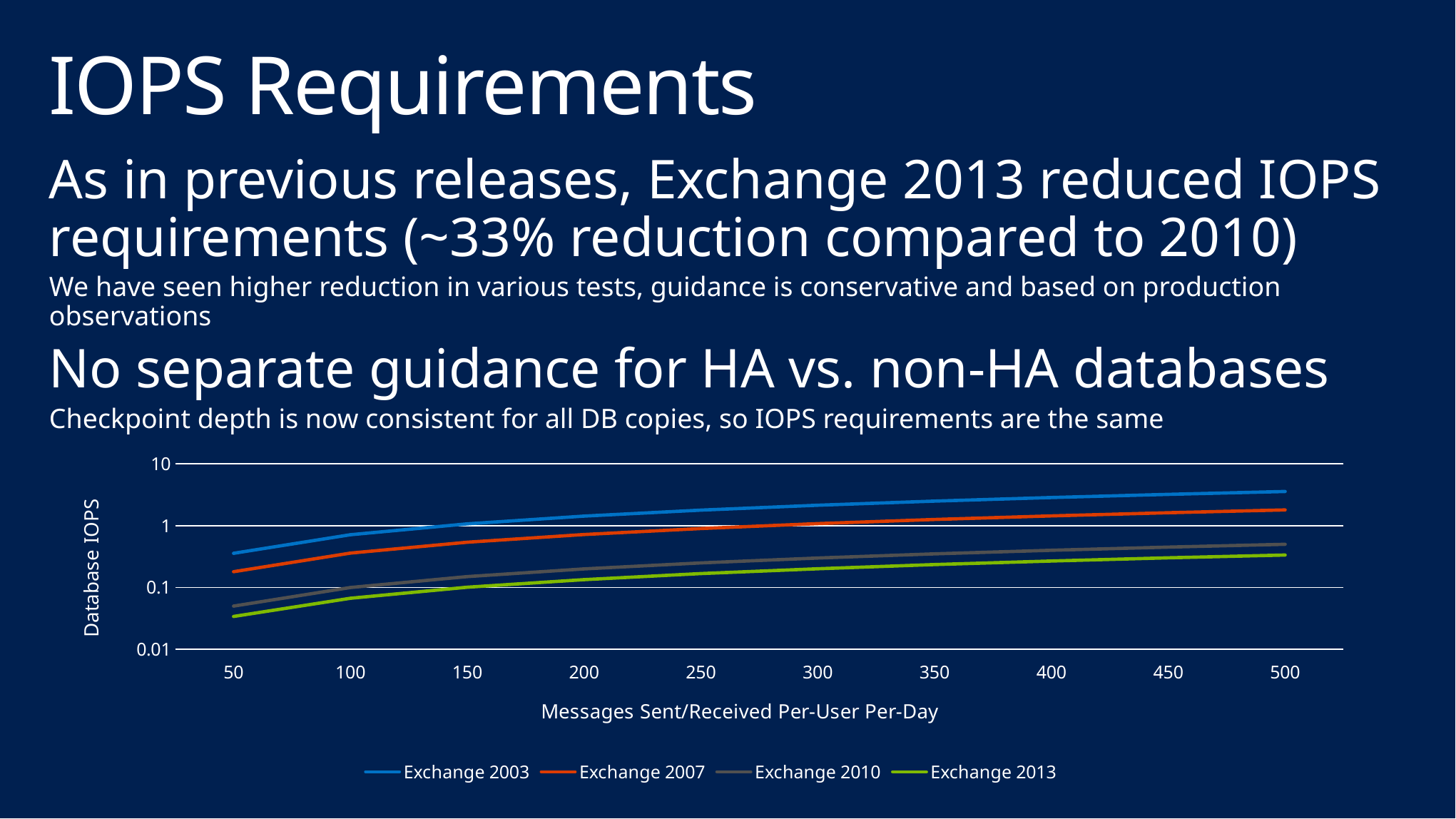
Is the Database IOPS value for Exchange 2013 at 50 messages per user per day greater or less than 0.1? less Is the Database IOPS value for Exchange 2003 at 500 messages per user per day greater or less than 1? greater Which series has the highest Database IOPS across the chart? Exchange 2003 What is the title of the y axis of the chart? Database IOPS At 500 messages per user per day, which is larger: the Database IOPS for Exchange 2003 or for Exchange 2013? Exchange 2003 How many series does the chart legend list? 4 Is the Database IOPS value for Exchange 2010 at 500 messages per user per day greater or less than 1? less What kind of chart is shown on the slide? line chart Which series has the lowest Database IOPS across the chart? Exchange 2013 What is the title of the x axis of the chart? Messages Sent/Received Per-User Per-Day Do the Database IOPS values for Exchange 2013 rise or fall as Messages Sent/Received Per-User Per-Day increases? rise How many tick values are shown on the x axis of the chart? 10